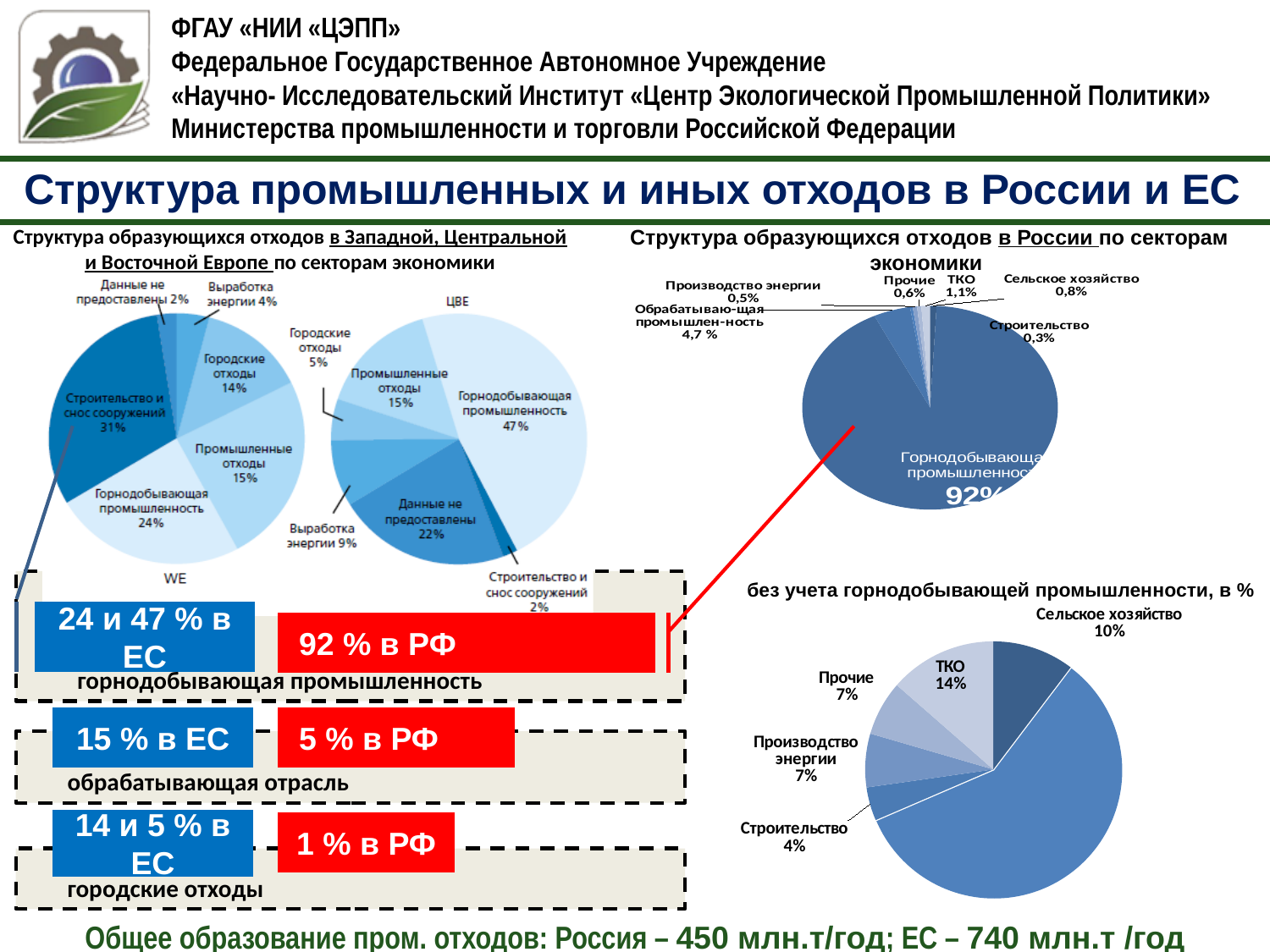
In the pie chart for Russia by economic sector (top right), what share is Обрабатывающая промышленность? 4,7 % In the pie chart without the mining industry (bottom right), what share is ТКО? 14% In the ЦВЕ pie chart, what is the difference between the share of Данные не предоставлены and the share of Выработка энергии? 13% In the pie chart for Russia by economic sector (top right), which sector has the smallest share? Строительство What type of chart is used to show the structure of waste in Russia by economic sector (top right)? Pie chart In the pie chart for Russia by economic sector (top right), what share is Горнодобывающая промышленность? 92% In the WE pie chart (Western Europe), what share is Городские отходы? 14% In the pie chart without the mining industry (bottom right), what share is Производство энергии? 7% In the pie chart for Russia by economic sector (top right), what is the share of ТКО? 1,1% In the ЦВЕ pie chart (Central and Eastern Europe), what share is Горнодобывающая промышленность? 47% In the WE pie chart (Western Europe), which sector has the largest share? Строительство и снос сооружений In the pie chart without the mining industry (bottom right), which is larger: Сельское хозяйство or Строительство? Сельское хозяйство